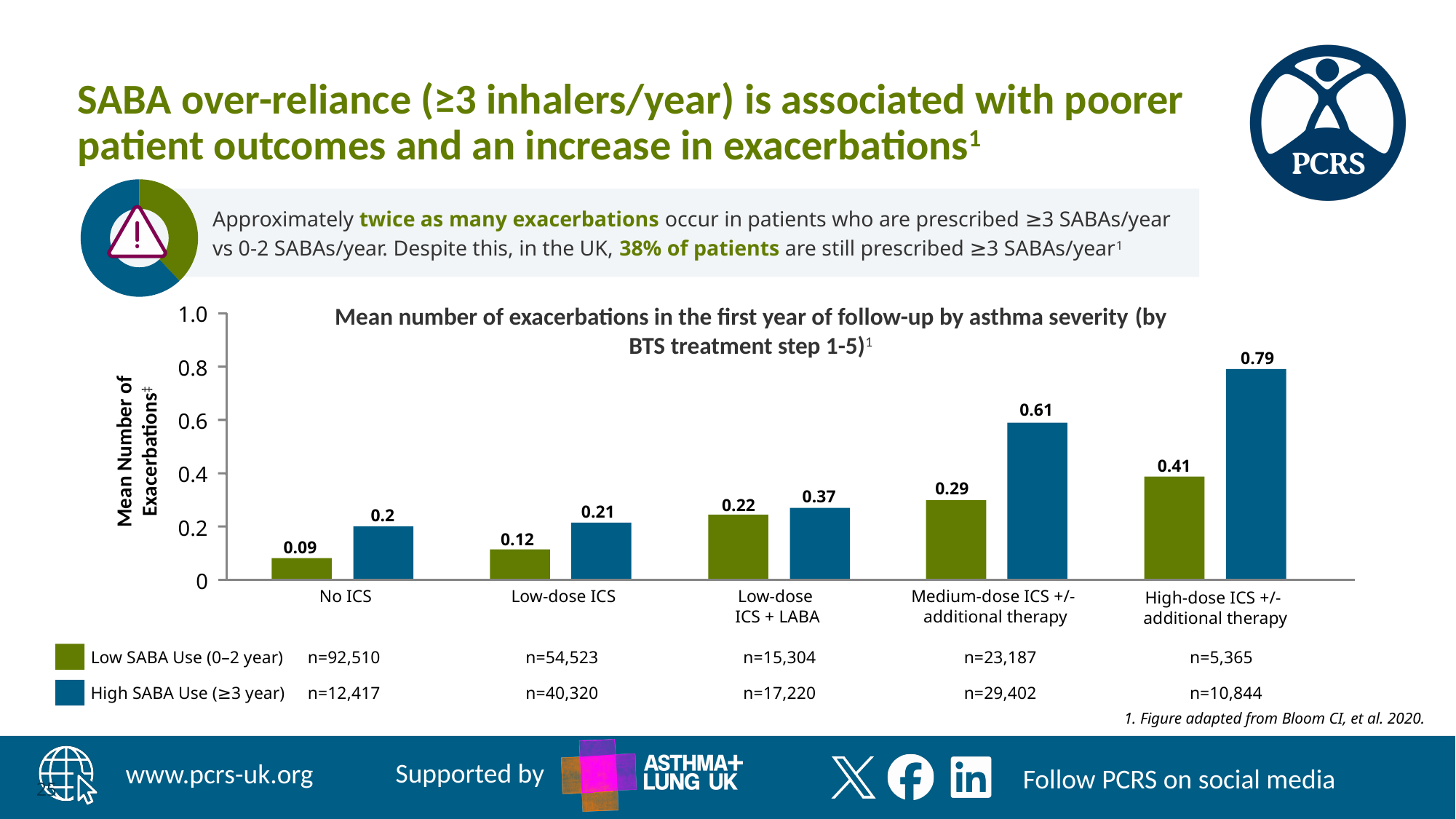
What is the mean number of exacerbations for High SABA Use in the Low-dose ICS + LABA group? 0.37 How many series does the chart legend list? 2 In the Low-dose ICS group, which is larger: the Low SABA Use value or the High SABA Use value? High SABA Use Which treatment group has the lowest mean number of exacerbations for High SABA Use? No ICS Which treatment group has the highest mean number of exacerbations for Low SABA Use? High-dose ICS +/- additional therapy What is the mean number of exacerbations for Low SABA Use in the No ICS group? 0.09 Do the High SABA Use values rise or fall as treatment step increases from No ICS to High-dose ICS +/- additional therapy? Rise What is the mean number of exacerbations for High SABA Use in the High-dose ICS +/- additional therapy group? 0.79 How many treatment groups are shown on the x axis of the chart? 5 Is the High SABA Use value for Medium-dose ICS +/- additional therapy greater or less than 0.6? greater What type of chart is shown on the slide? Bar chart What is the difference between High SABA Use and Low SABA Use in the Medium-dose ICS +/- additional therapy group? 0.32